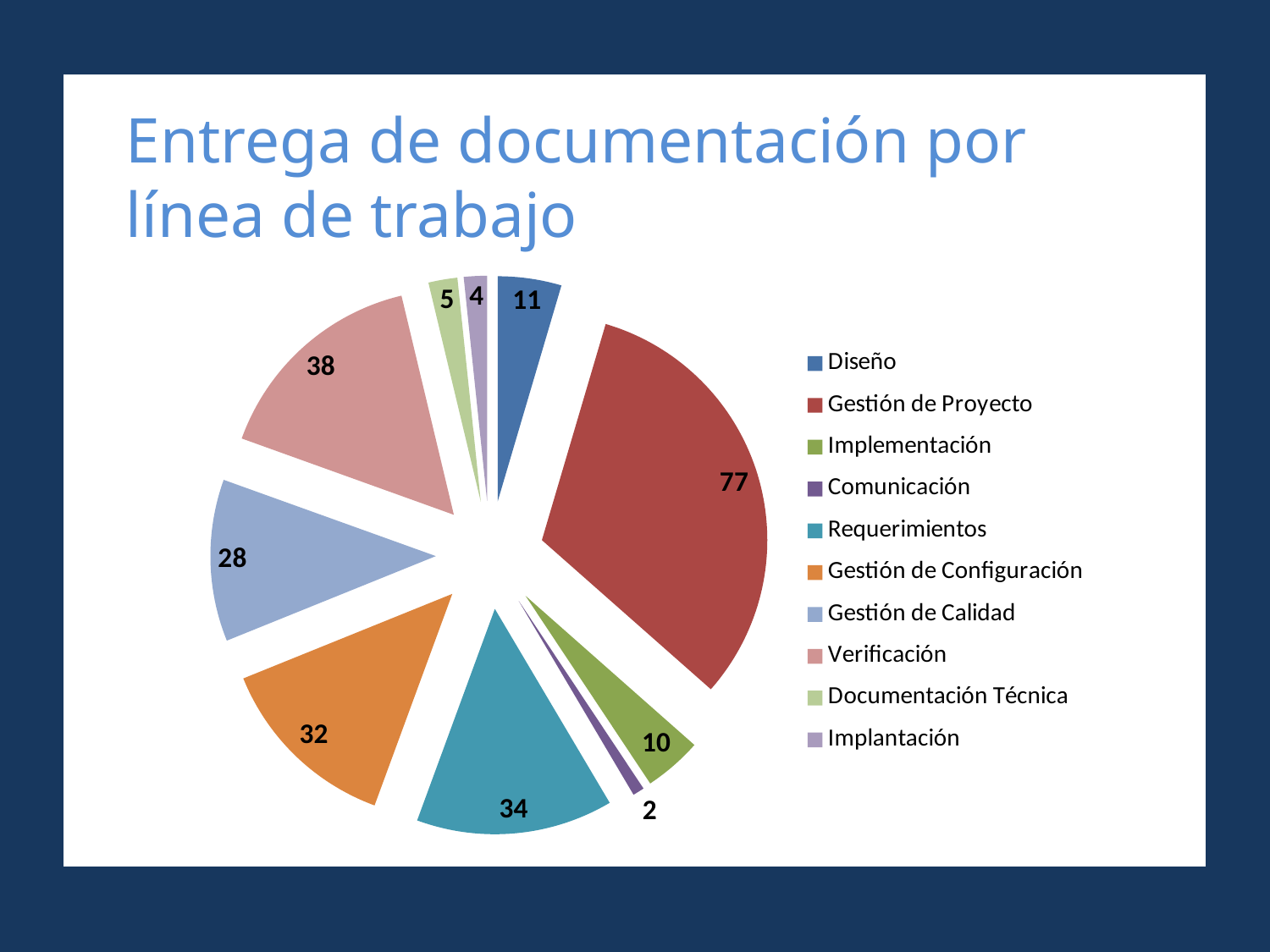
What is the value for Gestión de Proyecto? 77 Which category has the largest slice? Gestión de Proyecto Which is larger, Gestión de Configuración or Gestión de Calidad? Gestión de Configuración What is the title of the slide containing the chart? Entrega de documentación por línea de trabajo What type of chart is shown on the slide? pie chart Which category has the smallest slice? Comunicación How many categories does the pie chart have? 10 What is the difference between the values for Gestión de Proyecto and Verificación? 39 What is the value for Requerimientos? 34 What is the value for Comunicación? 2 What is the total of all the slice values in the pie chart? 241 What is the value for Verificación? 38